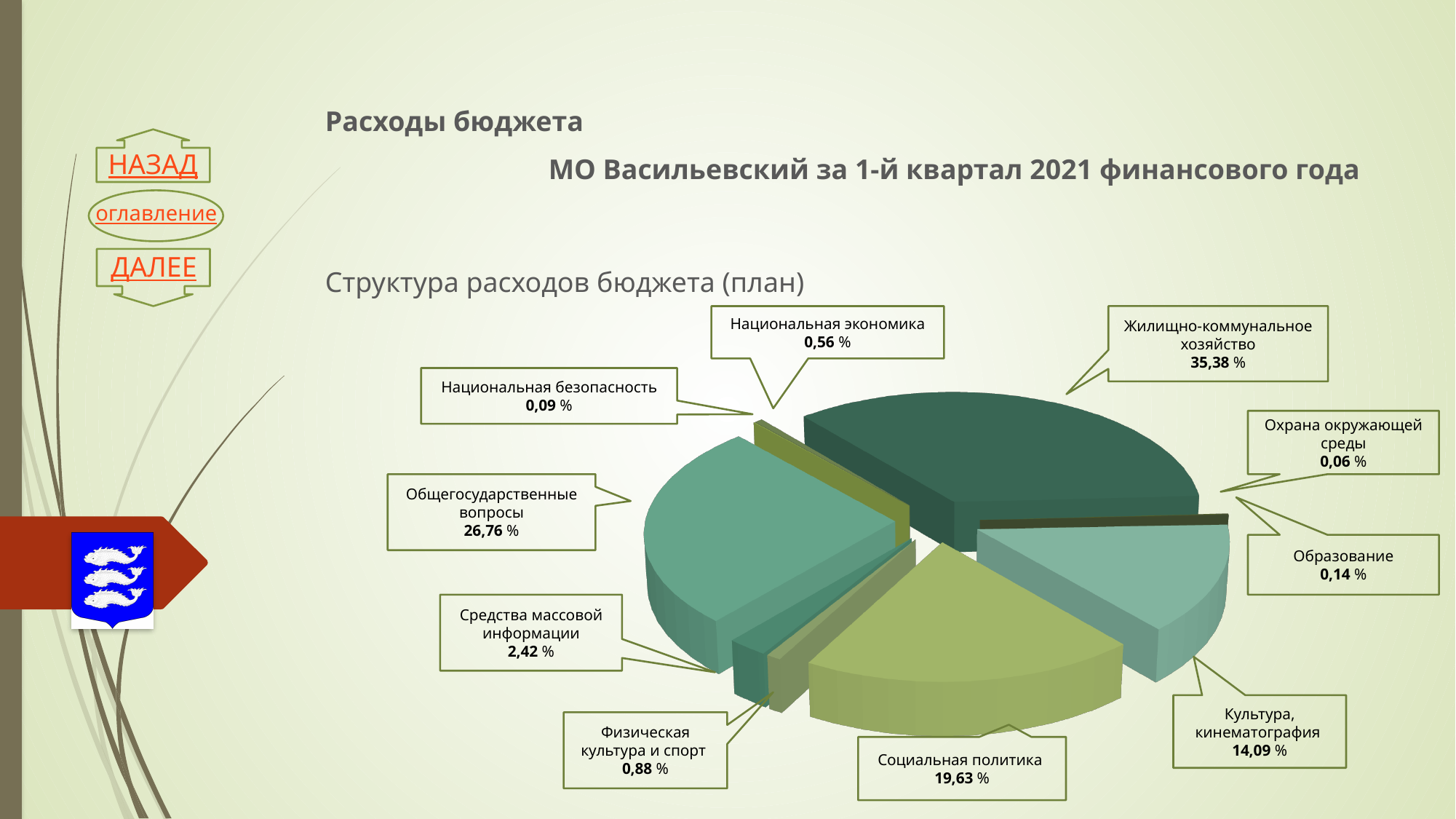
Which category has the largest share of the pie chart? Жилищно-коммунальное хозяйство What value is shown for Средства массовой информации? 2,42 % What is the subtitle of the chart on the slide? Структура расходов бюджета (план) What value is shown for Физическая культура и спорт? 0,88 % What is the difference in percentage points between Общегосударственные вопросы and Культура, кинематография? 12,67 What type of chart is shown on the slide? Pie chart What value is shown for Социальная политика in the pie chart? 19,63 % Which is larger: the share for Социальная политика or the share for Культура, кинематография? Социальная политика What share of the pie chart does Жилищно-коммунальное хозяйство account for? 35,38 % What is the combined share of Национальная экономика and Национальная безопасность? 0,65 % Which category has the smallest share of the pie chart? Охрана окружающей среды How many categories are shown in the pie chart? 10